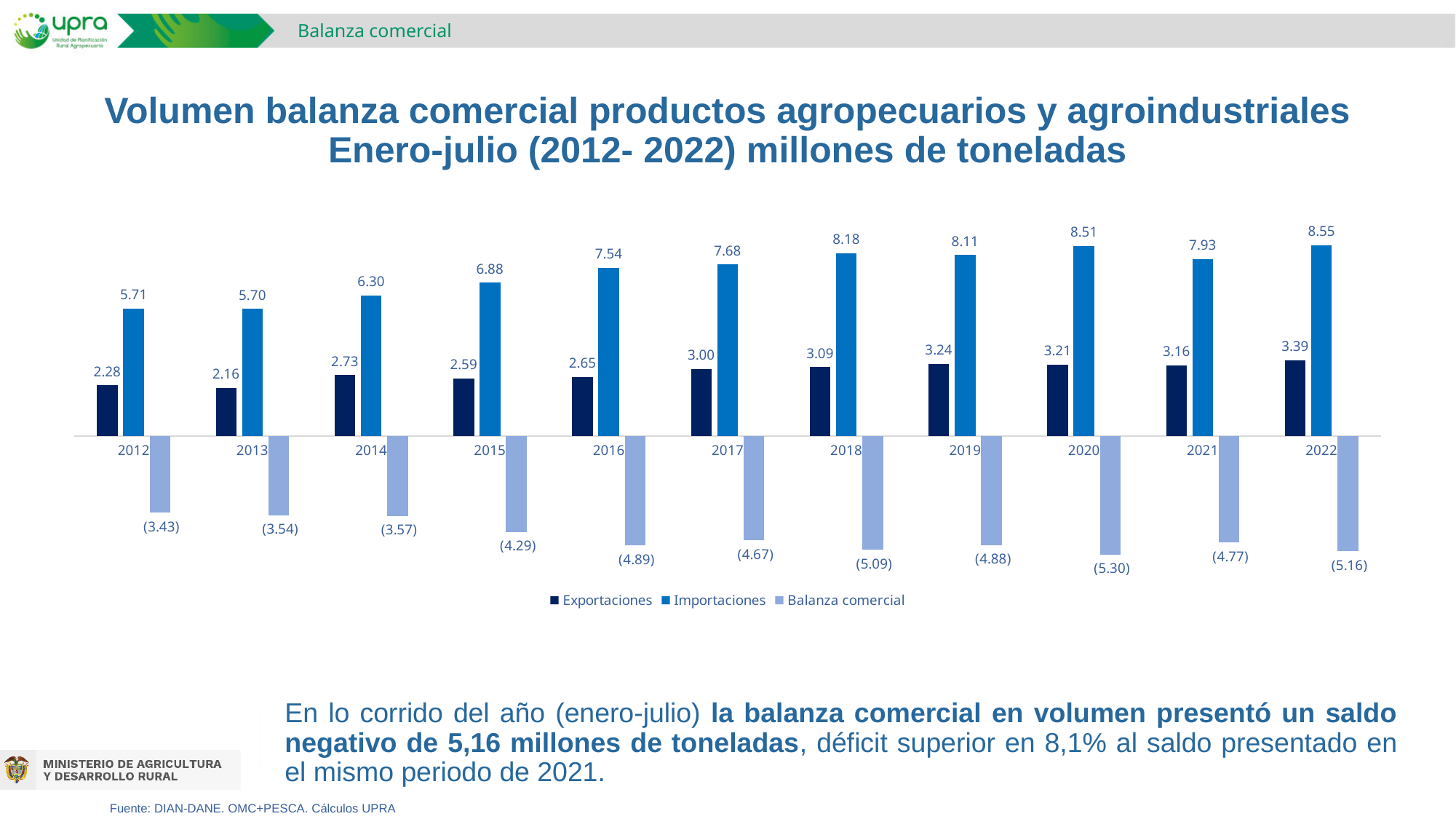
What kind of chart is shown on the slide? Bar chart How many years are shown on the x axis? 11 What is the value of Exportaciones for 2019? 3.24 In which year is Importaciones highest? 2022 What is the Balanza comercial value shown for 2020? (5.30) How many series does the legend list? 3 What are the three series listed in the legend? Exportaciones, Importaciones, Balanza comercial What is the value of Importaciones for 2016? 7.54 What is the difference between Importaciones and Exportaciones in 2022? 5.16 Which is larger, Exportaciones in 2019 or Exportaciones in 2020? 2019 In which year is Exportaciones lowest? 2013 Do the Importaciones values generally rise or fall from 2012 to 2022? Rise